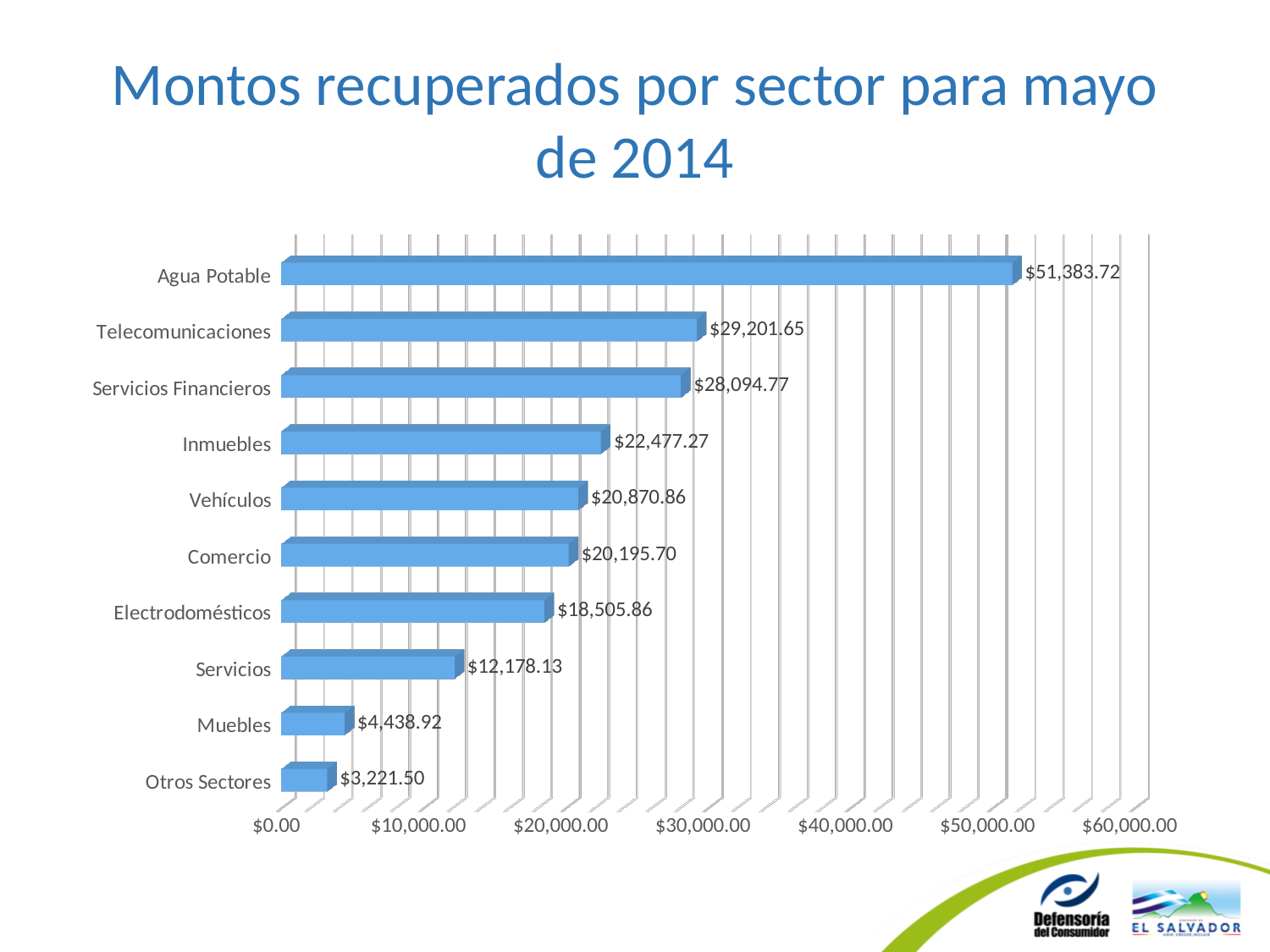
What kind of chart is shown on the slide? Bar chart How many sectors are shown in the chart? 10 What is the recovered amount for Electrodomésticos? $18,505.86 What is the recovered amount for Muebles? $4,438.92 What is the recovered amount for Agua Potable? $51,383.72 Is the value for Servicios greater or less than $10,000.00? greater What is the title of the slide? Montos recuperados por sector para mayo de 2014 Which has a larger recovered amount, Telecomunicaciones or Servicios Financieros? Telecomunicaciones Which sector has the highest recovered amount? Agua Potable What is the difference between the amounts for Muebles and Otros Sectores? $1,217.42 What is the difference between the amounts for Agua Potable and Telecomunicaciones? $22,182.07 Which sector has the lowest recovered amount? Otros Sectores